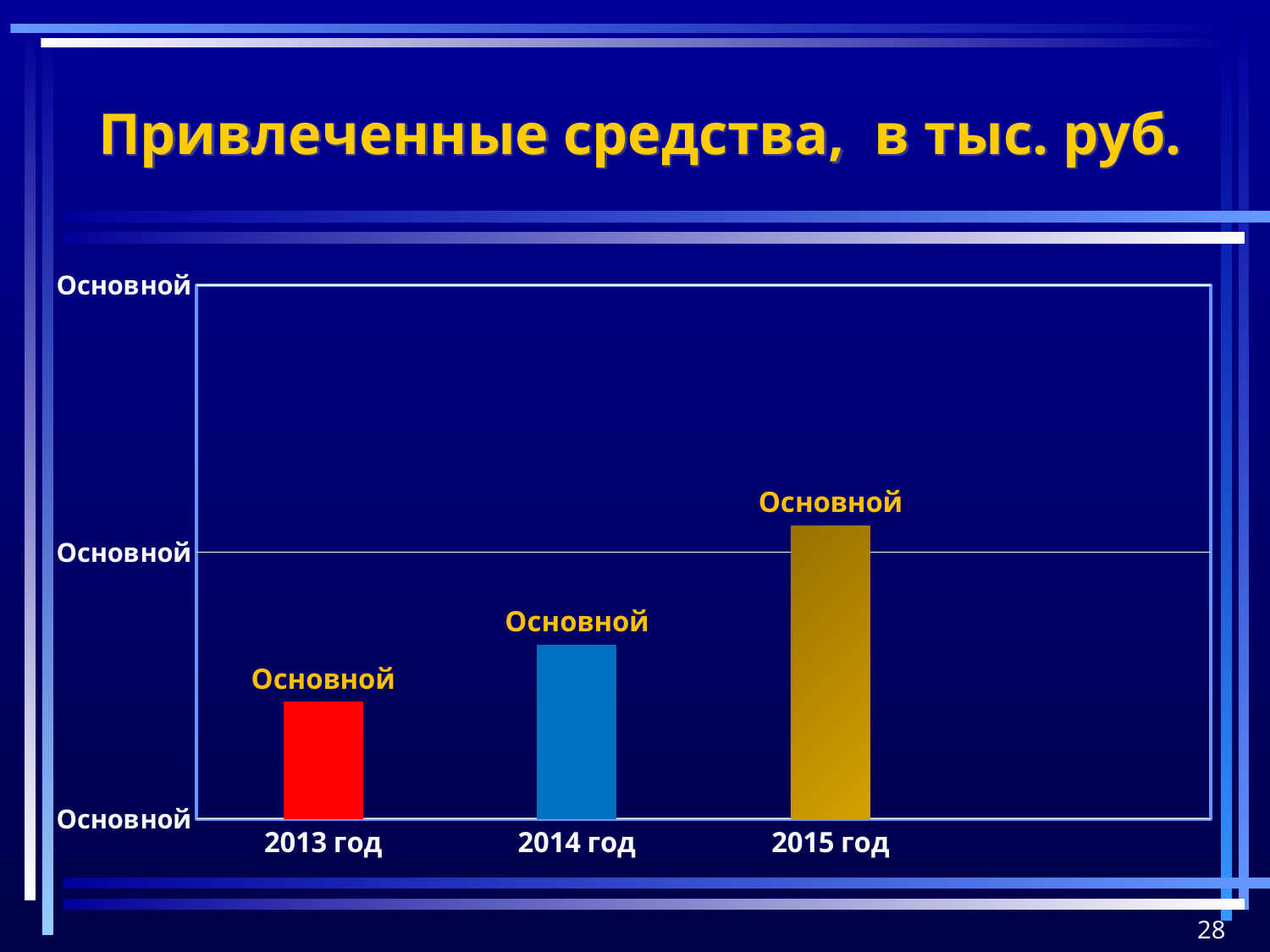
What kind of chart is shown on the slide? bar chart What colour is the bar for 2013 год? red Which year has the lowest bar in the chart? 2013 год Which year has the highest bar in the chart? 2015 год What are the category labels along the x axis of the chart? 2013 год, 2014 год, 2015 год What is the title of the chart on the slide? Привлеченные средства, в тыс. руб. How many categories (bars) are plotted in the chart? 3 Which is larger, the bar for 2015 год or the bar for 2014 год? 2015 год Do the values rise or fall from 2013 год to 2015 год? rise Which is larger, the bar for 2014 год or the bar for 2013 год? 2014 год